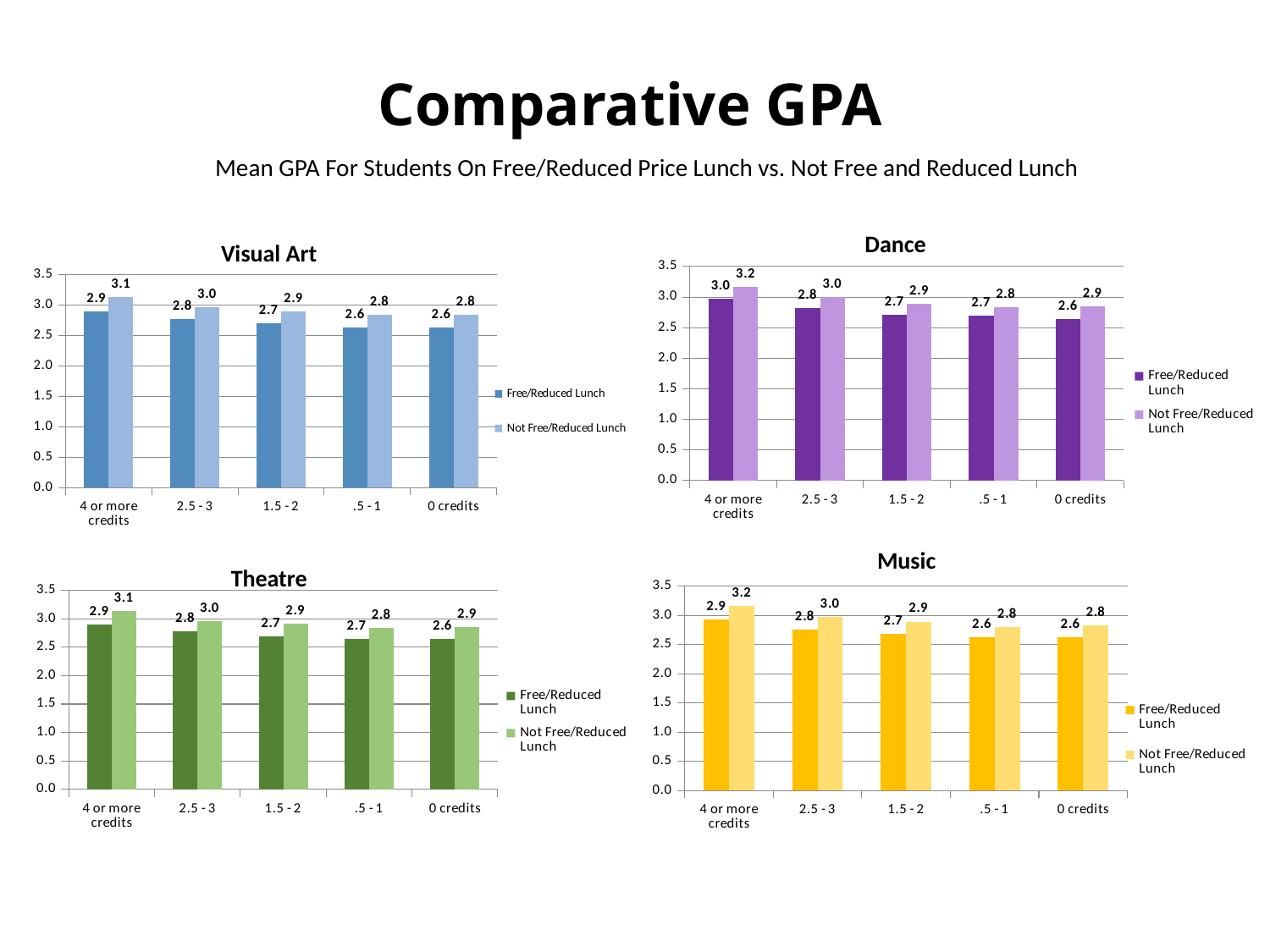
What is the title of the chart in the top-right position of the slide? Dance In the Visual Art chart, what is the mean GPA for Not Free/Reduced Lunch students with 4 or more credits? 3.1 In the Music chart, what is the difference between the Not Free/Reduced Lunch and Free/Reduced Lunch mean GPA for students with 4 or more credits? 0.3 What type of chart is the Music chart? Bar chart In the Visual Art chart, does the Free/Reduced Lunch mean GPA rise or fall from 4 or more credits to 0 credits? Fall In the Dance chart, what is the mean GPA for Free/Reduced Lunch students with 0 credits? 2.6 In the Dance chart, which credit category has the highest mean GPA for Not Free/Reduced Lunch students? 4 or more credits In the Music chart, what is the mean GPA for Not Free/Reduced Lunch students with 4 or more credits? 3.2 In the Visual Art chart, which is larger for the 2.5 - 3 credits category: the Free/Reduced Lunch GPA or the Not Free/Reduced Lunch GPA? Not Free/Reduced Lunch How many credit categories are shown on the x axis of the Theatre chart? 5 How many series does the legend of the Dance chart list? 2 In the Theatre chart, what is the mean GPA for Free/Reduced Lunch students in the 1.5 - 2 credits category? 2.7